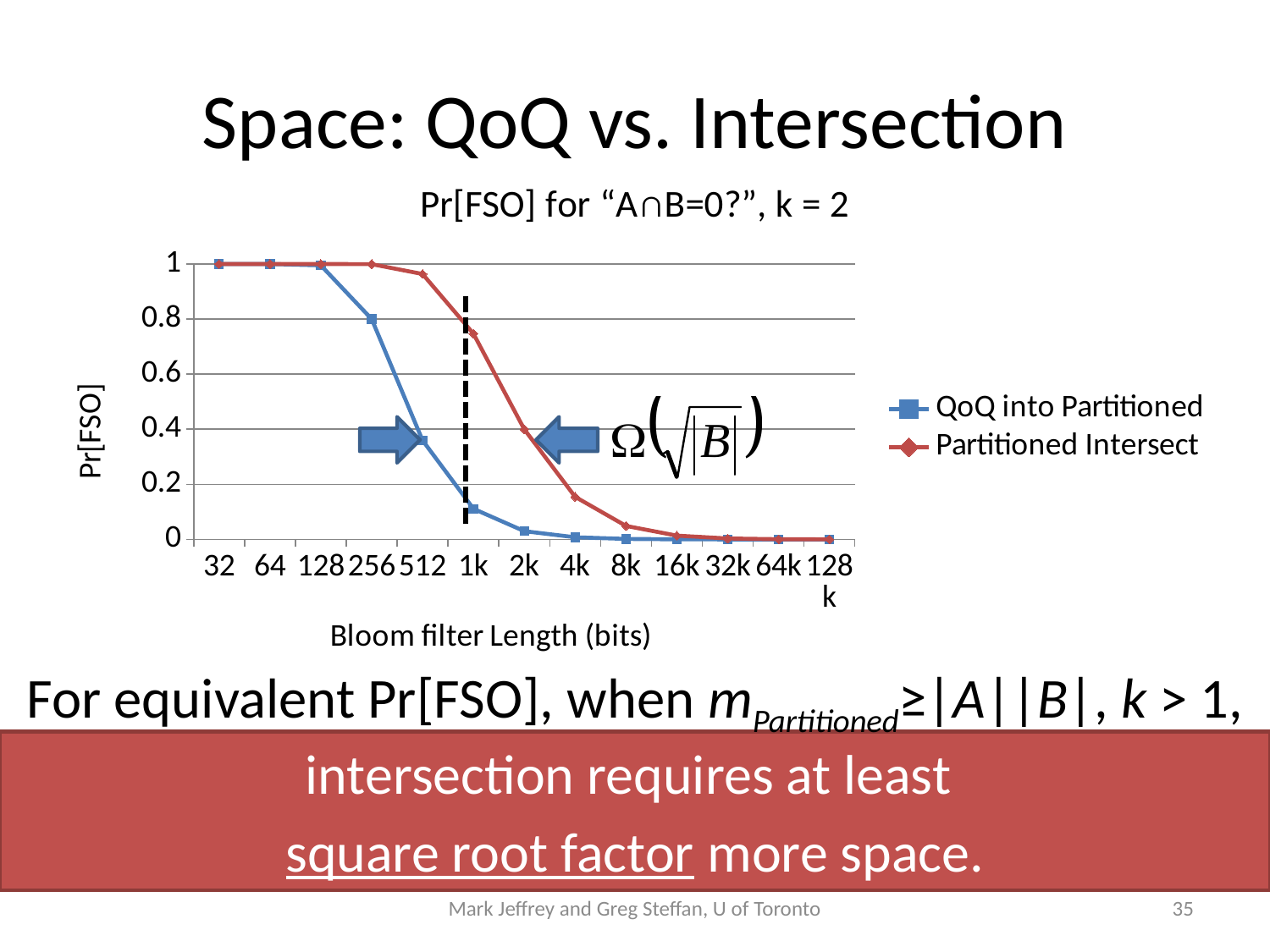
At a Bloom filter length of 2k bits, which series has the larger Pr[FSO], QoQ into Partitioned or Partitioned Intersect? Partitioned Intersect What is the title of the chart? Pr[FSO] for "A∩B=0?", k = 2 What is the label of the x axis? Bloom filter Length (bits) Is the Pr[FSO] value for QoQ into Partitioned at 512 bits greater or less than 0.6? less Is the Pr[FSO] value for QoQ into Partitioned at 1k bits greater or less than 0.2? less How many series does the legend list? 2 At a Bloom filter length of 512 bits, which series has the larger Pr[FSO], QoQ into Partitioned or Partitioned Intersect? Partitioned Intersect How many Bloom filter length values are shown on the x axis? 13 Is the Pr[FSO] value for Partitioned Intersect at 1k bits greater or less than 0.6? greater Do the Pr[FSO] values rise or fall as the Bloom filter length increases? fall What kind of chart is shown on the slide? line chart